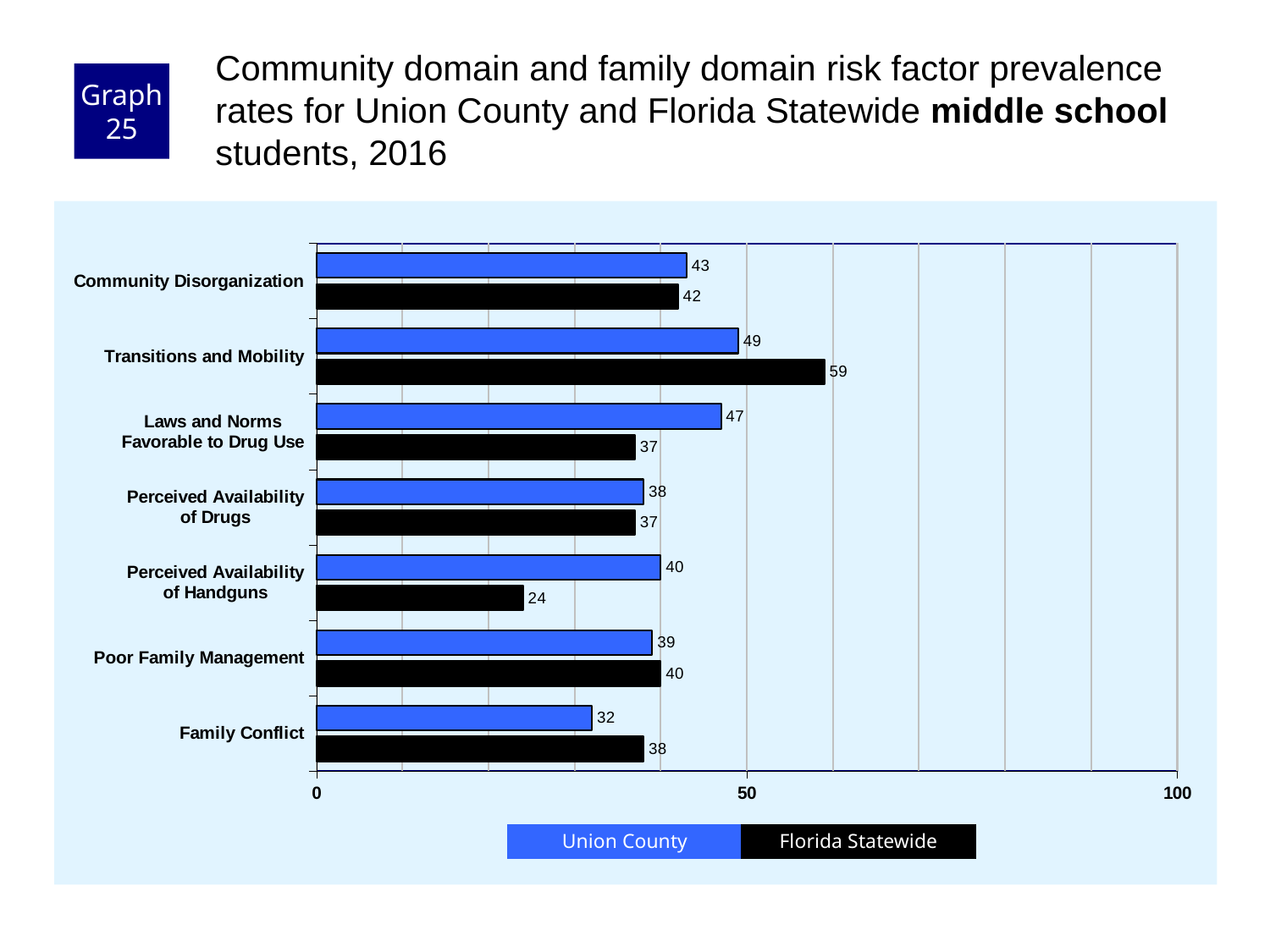
What is the difference between the Florida Statewide and Union County values for Transitions and Mobility? 10 What is the Florida Statewide value for Family Conflict? 38 What is the Florida Statewide value for Perceived Availability of Handguns? 24 Which risk factor has the lowest Florida Statewide value? Perceived Availability of Handguns Which risk factor has the highest Union County value? Transitions and Mobility Is the Florida Statewide value for Transitions and Mobility greater or less than 50? greater How many risk factors are shown on the chart? 7 How many series does the legend list? 2 What is the Union County value for Transitions and Mobility? 49 What is the difference between the Union County and Florida Statewide values for Perceived Availability of Handguns? 16 What kind of chart is shown on the slide? bar chart For Laws and Norms Favorable to Drug Use, which is larger: the Union County value or the Florida Statewide value? Union County